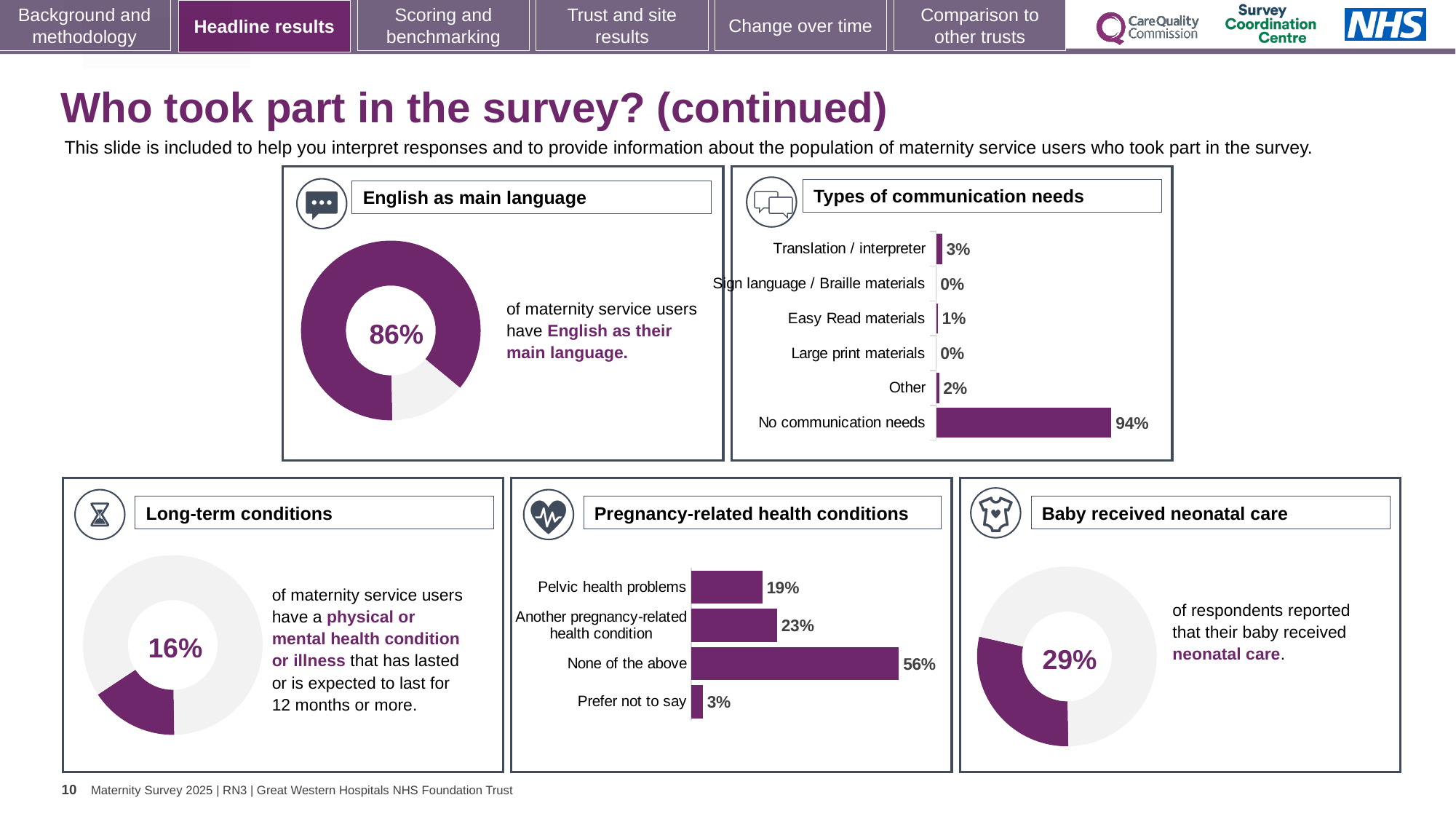
In the 'Types of communication needs' chart, how many categories are shown? 6 In the 'Types of communication needs' chart, what is the value for 'No communication needs'? 94% In the 'Types of communication needs' chart, what is the value for 'Translation / interpreter'? 3% In the 'Long-term conditions' chart, what percentage of maternity service users have a physical or mental health condition or illness? 16% What kind of chart is used in the 'Pregnancy-related health conditions' panel? Bar chart In the 'Types of communication needs' chart, which category has the highest value? No communication needs In the 'English as main language' chart, what percentage of maternity service users have English as their main language? 86% In the 'Pregnancy-related health conditions' chart, which is larger: 'Pelvic health problems' or 'Another pregnancy-related health condition'? Another pregnancy-related health condition In the 'Pregnancy-related health conditions' chart, what is the value for 'Another pregnancy-related health condition'? 23% In the 'Pregnancy-related health conditions' chart, which category has the lowest value? Prefer not to say In the 'Pregnancy-related health conditions' chart, what is the difference between 'None of the above' and 'Pelvic health problems'? 37% In the 'Baby received neonatal care' chart, what percentage of respondents reported that their baby received neonatal care? 29%